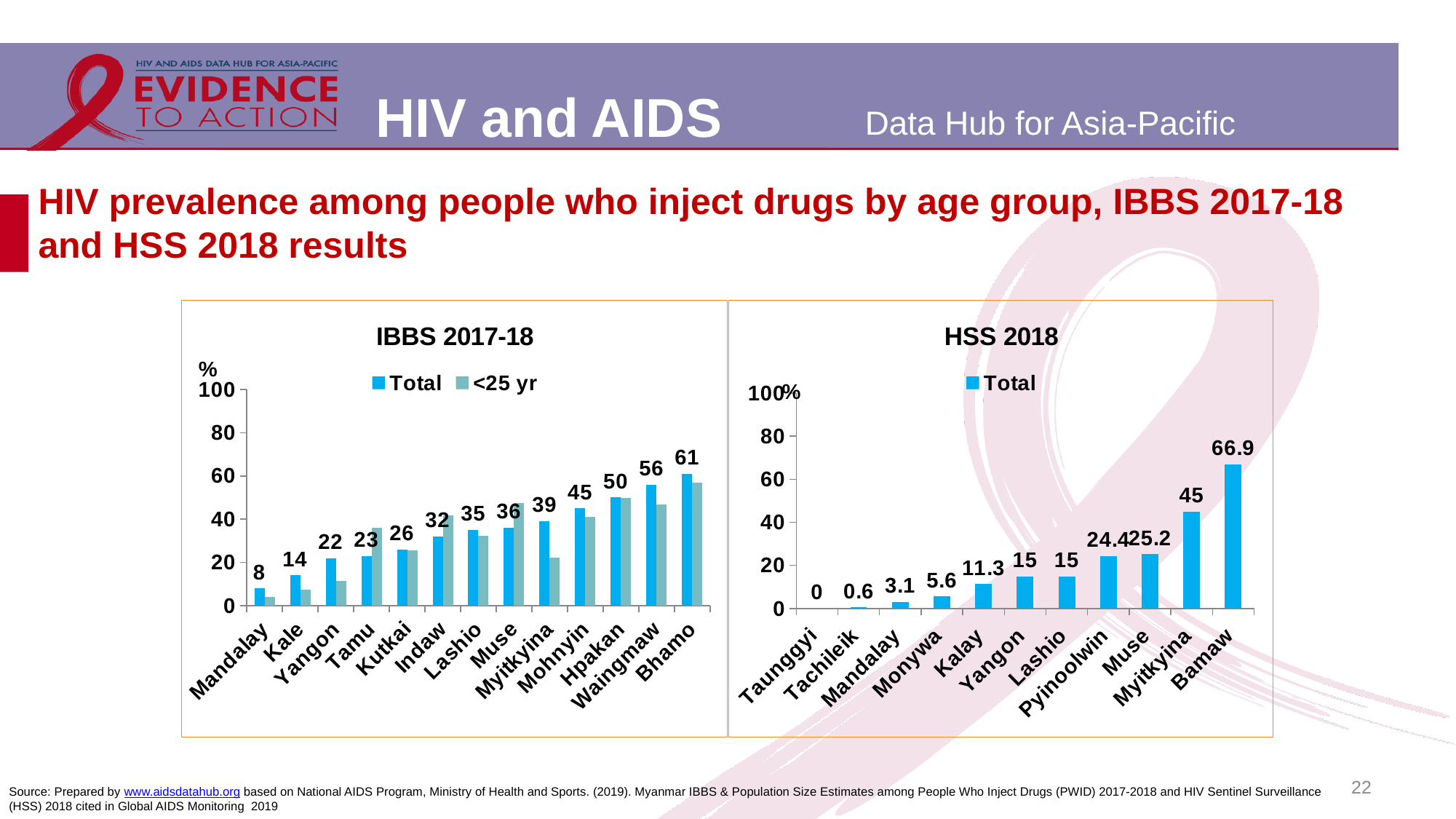
In the IBBS 2017-18 chart, which location has the lowest Total value? Mandalay In the IBBS 2017-18 chart, how many series does the legend list? 2 In the IBBS 2017-18 chart, is the <25 yr value for Myitkyina greater or less than 40? less In the HSS 2018 chart, what is the Total value for Pyinoolwin? 24.4 In the HSS 2018 chart, how many locations are shown on the x axis? 11 In the HSS 2018 chart, which location has the highest value? Bamaw In the IBBS 2017-18 chart, what is the Total value for Kutkai? 26 In the IBBS 2017-18 chart, what is the difference between the Total values for Waingmaw and Hpakan? 6 What type of chart is the HSS 2018 chart? Bar chart In the IBBS 2017-18 chart, how many locations are shown on the x axis? 13 In the IBBS 2017-18 chart, what is the Total HIV prevalence for Bhamo? 61 In the HSS 2018 chart, which is larger, the value for Muse or the value for Kalay? Muse